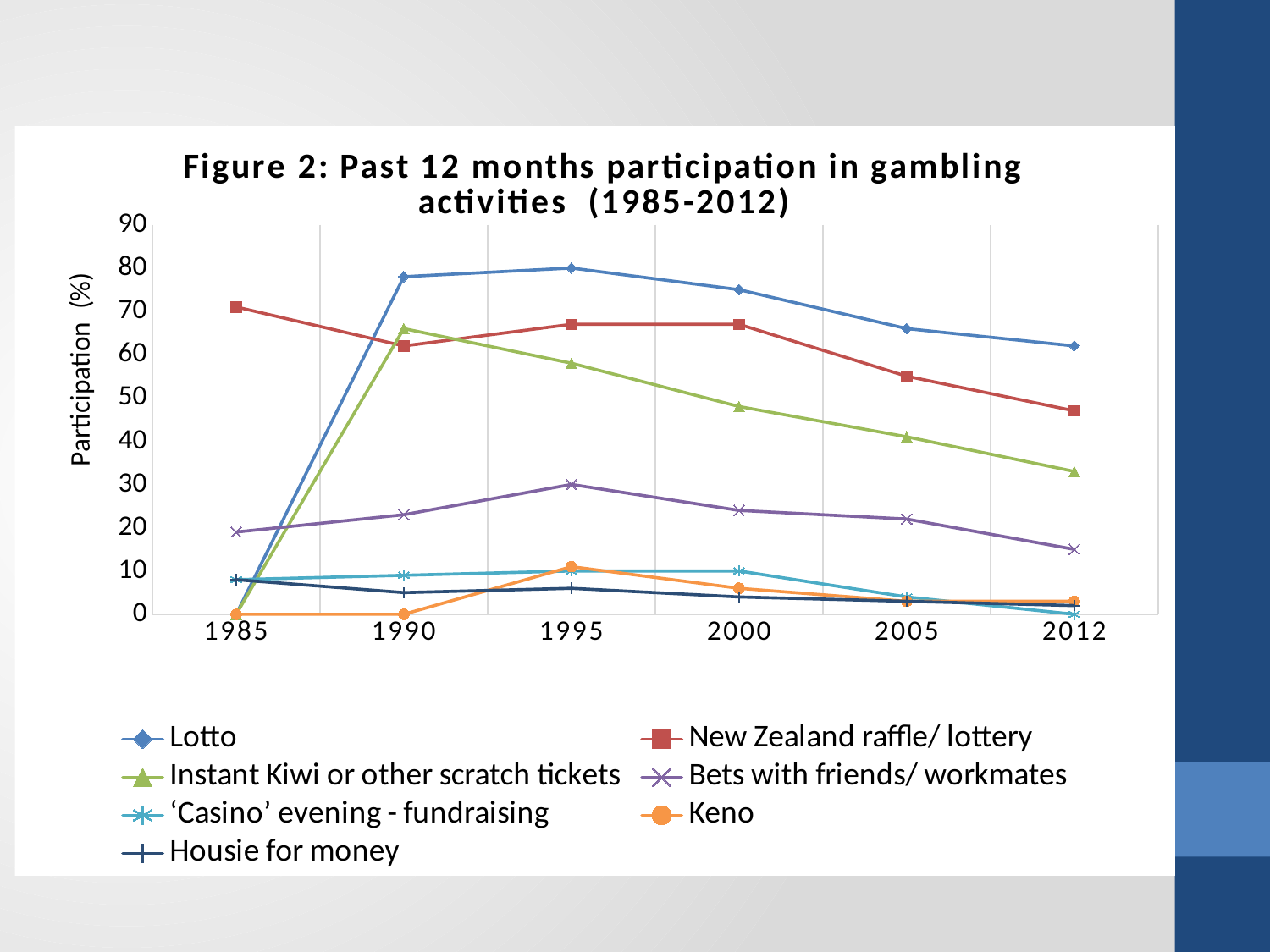
Which is larger in 2000: Lotto or New Zealand raffle/ lottery? Lotto Which activity has the highest participation in 1995? Lotto Is the value for Instant Kiwi or other scratch tickets in 2012 greater or less than 40? less Does participation in Instant Kiwi or other scratch tickets rise or fall from 1990 to 2012? fall Is the value for Lotto in 1990 greater or less than 70? greater What is the label of the y axis? Participation (%) Is the value for Bets with friends/ workmates in 2005 greater or less than 20? greater Which activity has the highest participation in 1985? New Zealand raffle/ lottery Which activity has the lowest participation in 1990? Keno How many series does the legend list? 7 How many years are shown along the x axis? 6 What kind of chart is shown on the slide? line chart